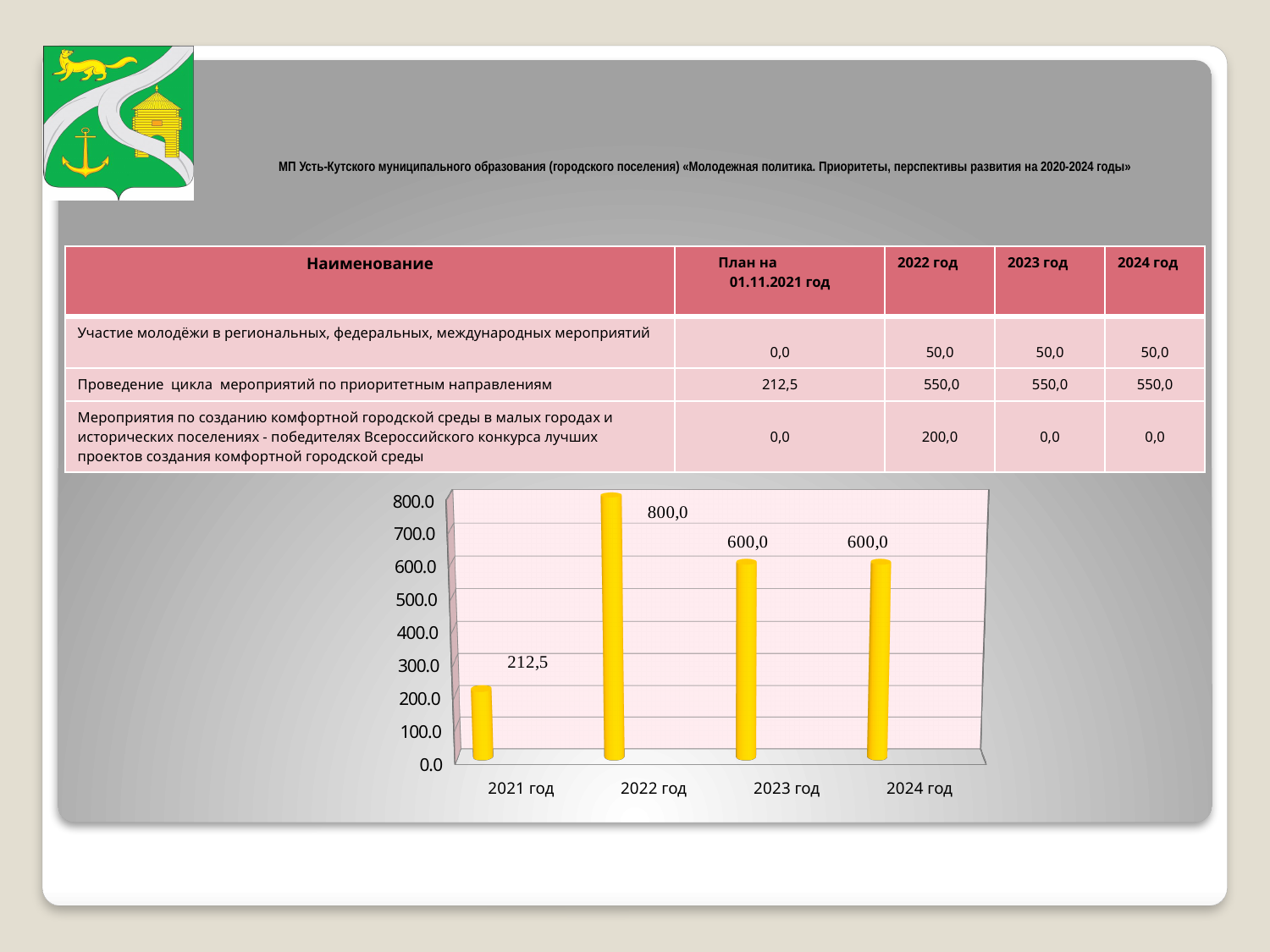
What is the value for 2023 год in the bar chart? 600,0 Which year has the highest value in the bar chart? 2022 год How many years (categories) are shown on the x axis of the bar chart? 4 Which year has the lowest value in the bar chart? 2021 год What kind of chart is shown on the slide? bar chart Which is larger in the bar chart: the value for 2021 год or the value for 2024 год? 2024 год What is the value for 2024 год in the bar chart? 600,0 What is the difference between the values for 2022 год and 2021 год in the bar chart? 587,5 Is the value for 2021 год in the bar chart greater or less than 300.0? less What is the value for 2021 год in the bar chart? 212,5 What is the difference between the values for 2022 год and 2023 год in the bar chart? 200,0 What is the value for 2022 год in the bar chart? 800,0